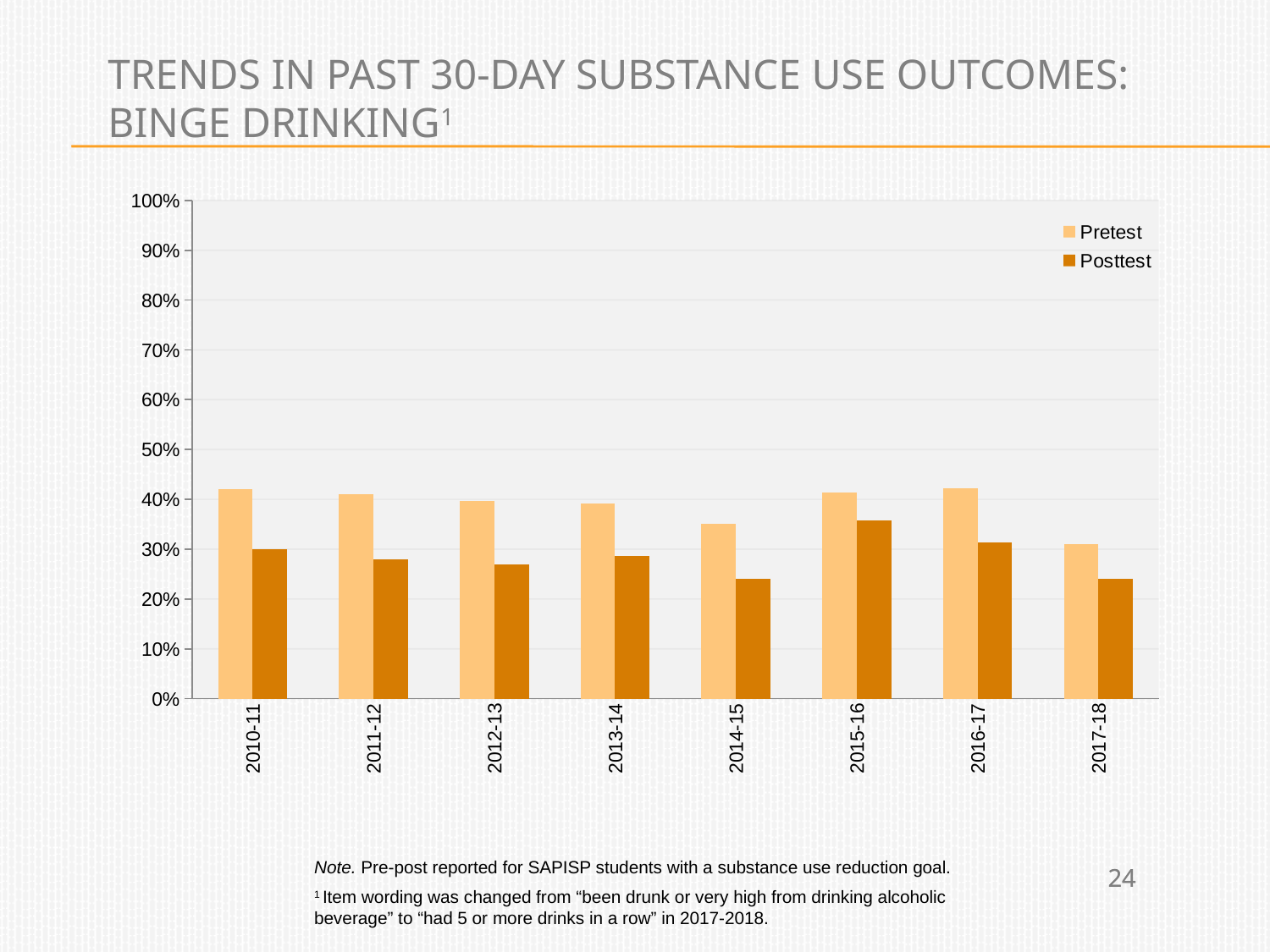
Which is larger, the Posttest value for 2015-16 or the Posttest value for 2014-15? 2015-16 How many series does the legend list? 2 Is the Posttest value for 2014-15 greater or less than 30%? less In 2010-11, which is larger, the Pretest value or the Posttest value? Pretest Which year has the highest Posttest value? 2015-16 How many school years are shown on the x axis? 8 Is the Pretest value for 2014-15 greater or less than 40%? less Is the Posttest value for 2015-16 greater or less than 30%? greater Which series does the legend list first? Pretest What kind of chart is shown on the slide? bar chart Which year has the lowest Pretest value? 2017-18